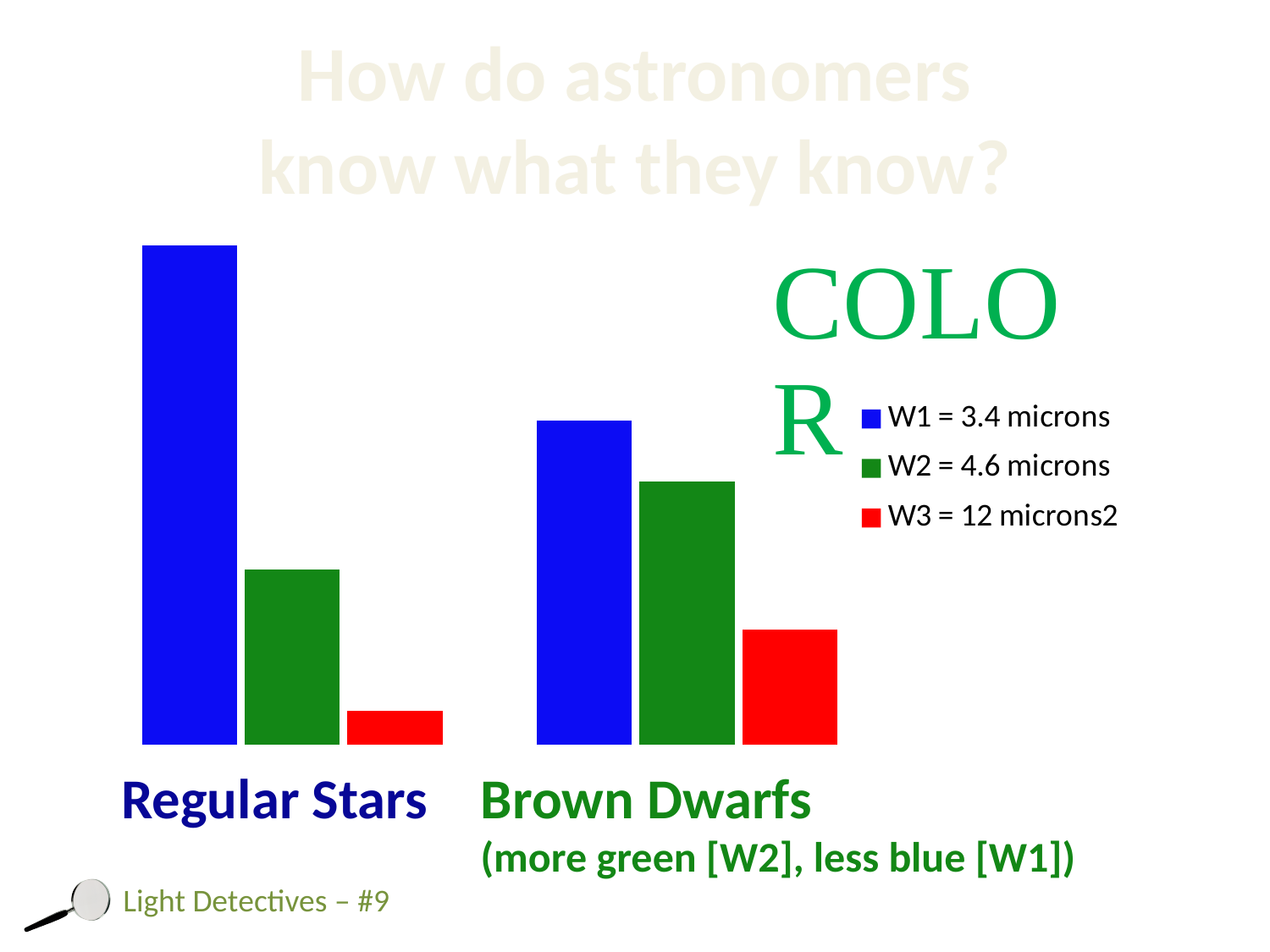
Which series has the shortest bar for Brown Dwarfs? W3 = 12 microns2 Which series has the tallest bar for Regular Stars? W1 = 3.4 microns What kind of chart is shown on the slide? bar chart How many series does the chart's legend list? 3 Is the W1 bar taller for Regular Stars or for Brown Dwarfs? Regular Stars What colour represents the W2 = 4.6 microns series in the chart? green Is the W2 bar taller for Regular Stars or for Brown Dwarfs? Brown Dwarfs Is the W3 bar taller for Regular Stars or for Brown Dwarfs? Brown Dwarfs What are the two category labels shown below the bars? Regular Stars, Brown Dwarfs Which series has the shortest bar for Regular Stars? W3 = 12 microns2 How many categories are shown on the x axis of the chart? 2 Which series has the tallest bar for Brown Dwarfs? W1 = 3.4 microns